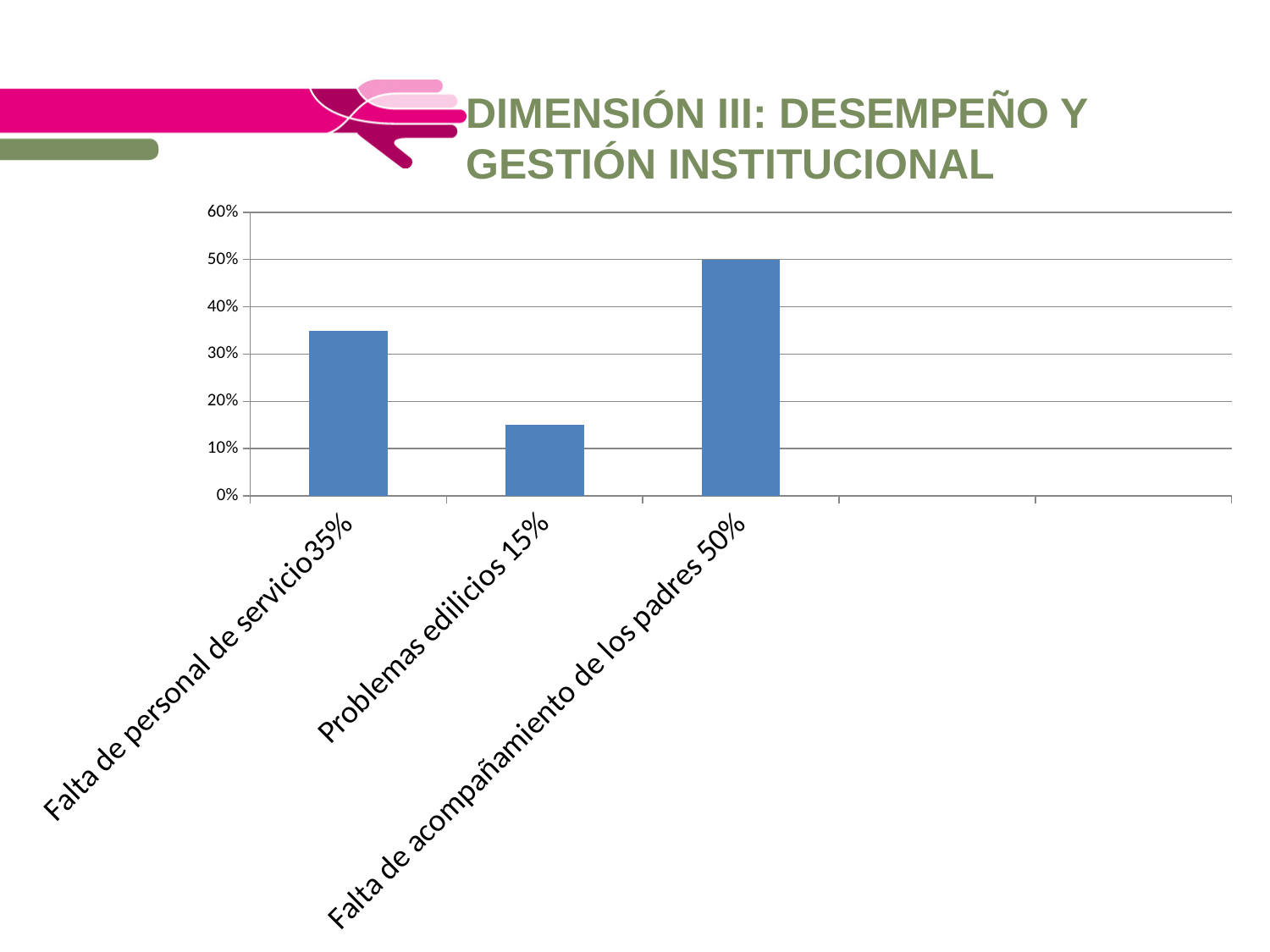
What is the value for Falta de personal de servicio? 35% Which is larger, the value for Falta de personal de servicio or the value for Problemas edilicios? Falta de personal de servicio Which category has the highest value? Falta de acompañamiento de los padres How many categories have bars in the chart? 3 What is the value for Problemas edilicios? 15% What is the difference between the values for Falta de acompañamiento de los padres and Problemas edilicios? 35% What is the difference between the values for Falta de personal de servicio and Problemas edilicios? 20% Is the value for Problemas edilicios greater or less than 10%? greater Is the value for Falta de personal de servicio greater or less than 40%? less What kind of chart is shown on the slide? Bar chart What is the value for Falta de acompañamiento de los padres? 50% Which category has the lowest value? Problemas edilicios